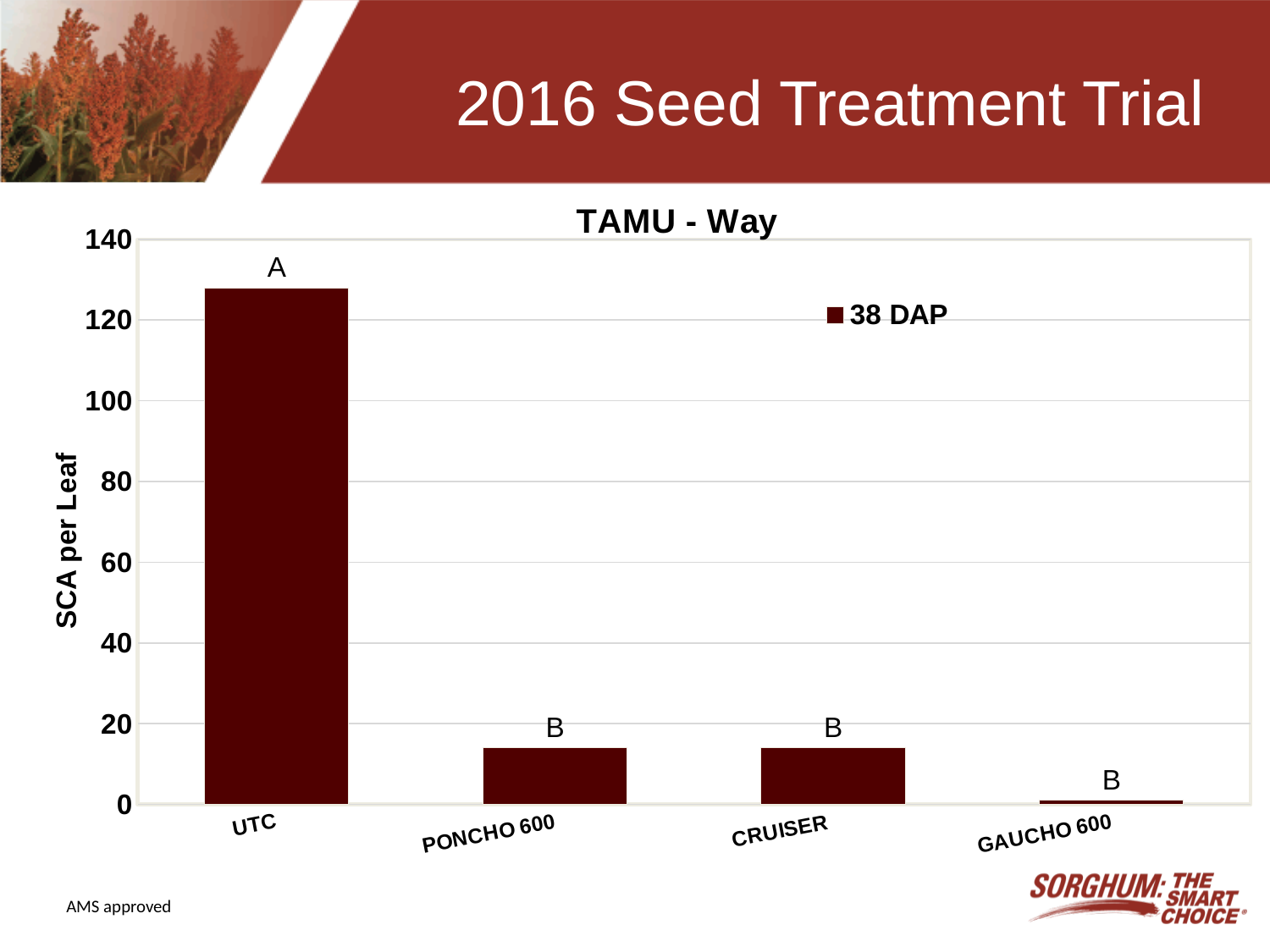
Which has a larger SCA per Leaf value, CRUISER or GAUCHO 600? CRUISER Is the value for UTC greater or less than 120? greater Which treatment has the highest SCA per Leaf? UTC Is the value for PONCHO 600 greater or less than 20? less Is the value for GAUCHO 600 greater or less than 20? less What is the name of the series shown in the legend? 38 DAP How many treatment categories are shown on the x axis? 4 What is the title of the chart? TAMU - Way Which has a larger SCA per Leaf value, UTC or CRUISER? UTC Which treatment has the lowest SCA per Leaf? GAUCHO 600 How many series does the legend list? 1 What kind of chart is shown on the slide? bar chart